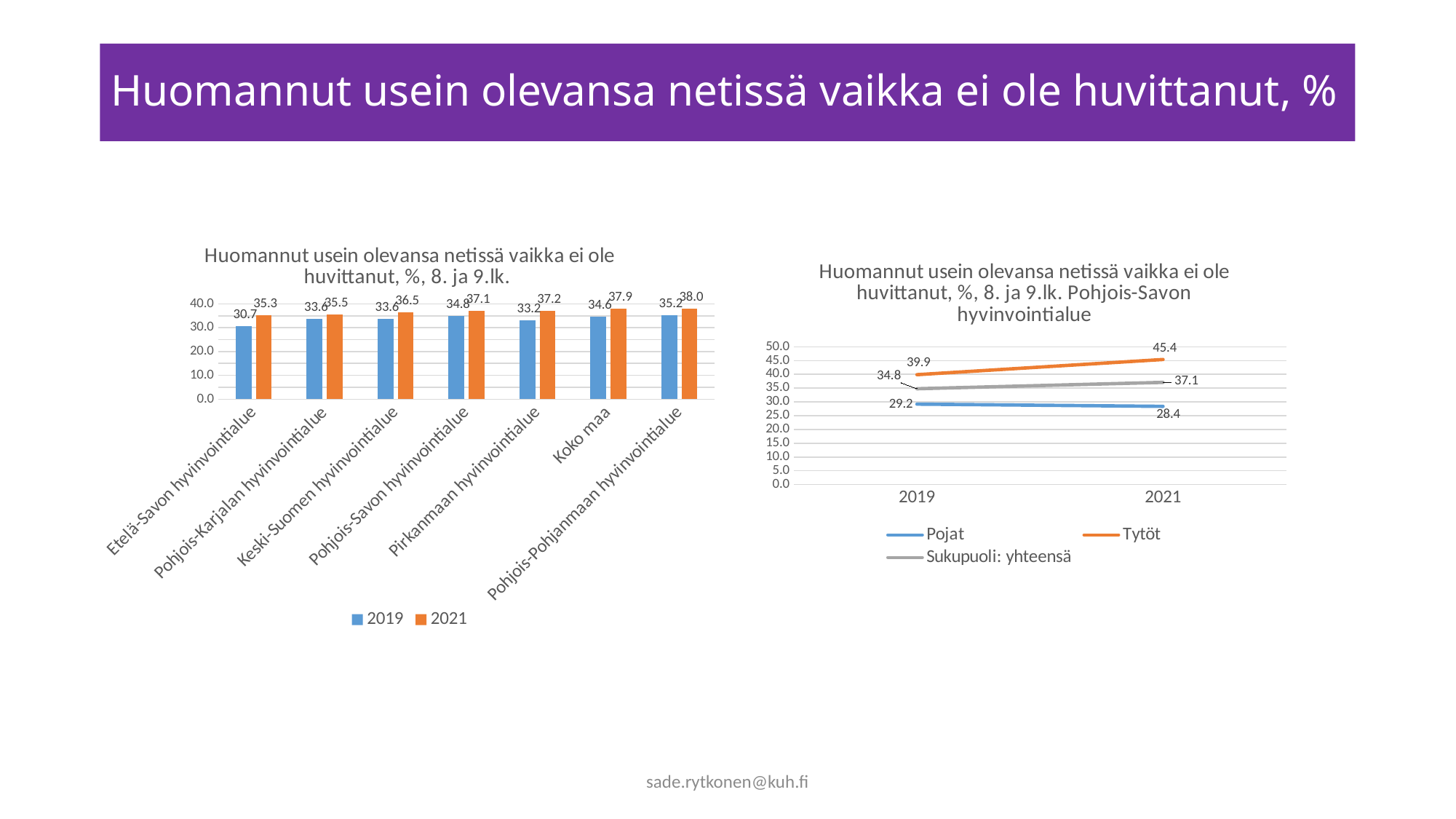
In the right chart, does the Pojat line rise or fall from 2019 to 2021? Fall In the left chart, what is the 2021 value for Pohjois-Savon hyvinvointialue? 37.1 In the left chart, what is the 2019 value for Etelä-Savon hyvinvointialue? 30.7 In the right chart, what is the difference between the Tytöt and Pojat values in 2021? 17.0 In the left chart, what is the difference between the 2021 and 2019 values for Koko maa? 3.3 In the left chart, which category has the lowest 2019 value? Etelä-Savon hyvinvointialue In the right chart, how many series does the legend list? 3 What kind of chart is the left chart? Bar chart In the right chart, what is the value for Pojat in 2019? 29.2 In the left chart, which category has the highest 2021 value? Pohjois-Pohjanmaan hyvinvointialue In the left chart, how many categories are shown on the x axis? 7 In the right chart, what is the value for Tytöt in 2021? 45.4